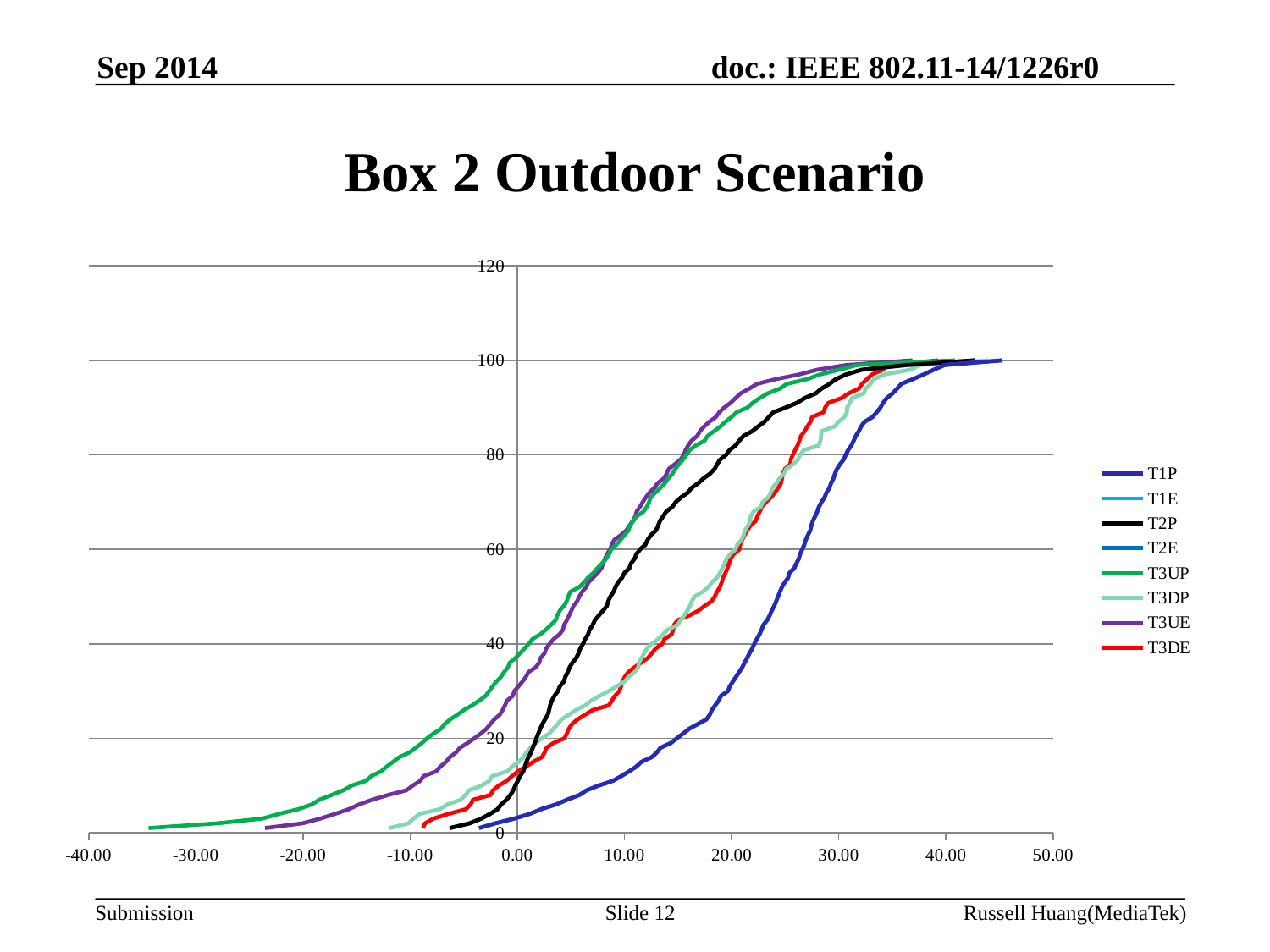
At x = 20.00, which curve has the larger value, T2P or T1P? T2P Is the value of the T3UE curve at x = 20.00 greater or less than 80? greater Is the value of the T3UP curve at x = -20.00 greater or less than 20? less Do the plotted curves rise or fall as the x-axis value increases? rise What is the title of the chart? Box 2 Outdoor Scenario How many series does the legend list? 8 What kind of chart is shown on the slide? line chart Which series is drawn in red according to the legend? T3DE Which series' curve begins furthest to the left on the x-axis? T3UP Is the value of the T3DE curve at x = 10.00 greater or less than 40? less